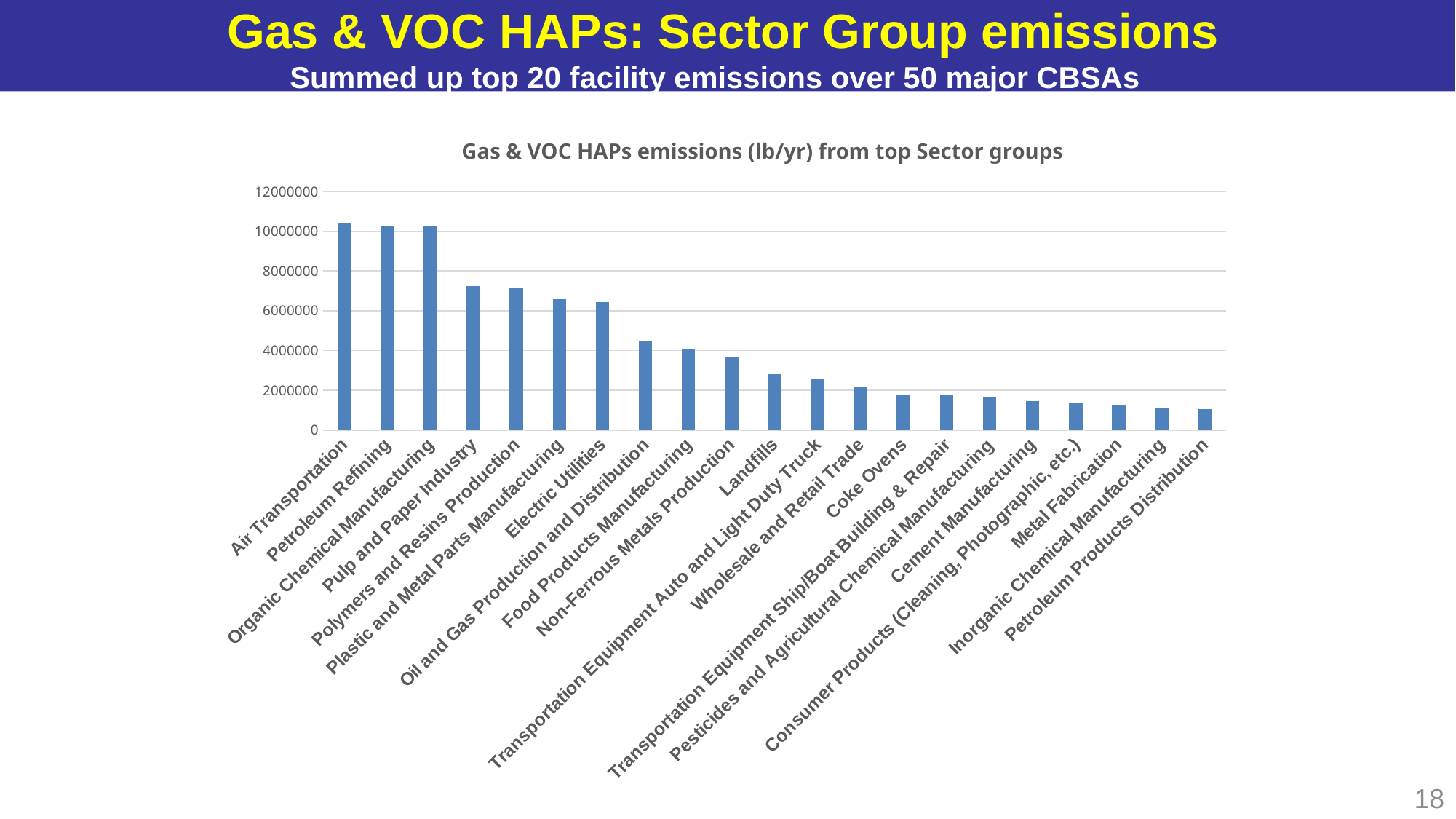
Which has the larger value, Electric Utilities or Metal Fabrication? Electric Utilities Is the value for Electric Utilities greater or less than 6000000? greater Which has the larger value, Pulp and Paper Industry or Landfills? Pulp and Paper Industry How many sector groups are plotted in the chart? 21 Do the emission values rise or fall moving from left to right along the x axis? fall What kind of chart is shown on the slide? bar chart What is the title of the chart? Gas & VOC HAPs emissions (lb/yr) from top Sector groups Is the value for Non-Ferrous Metals Production greater or less than 4000000? less Is the value for Landfills greater or less than 4000000? less